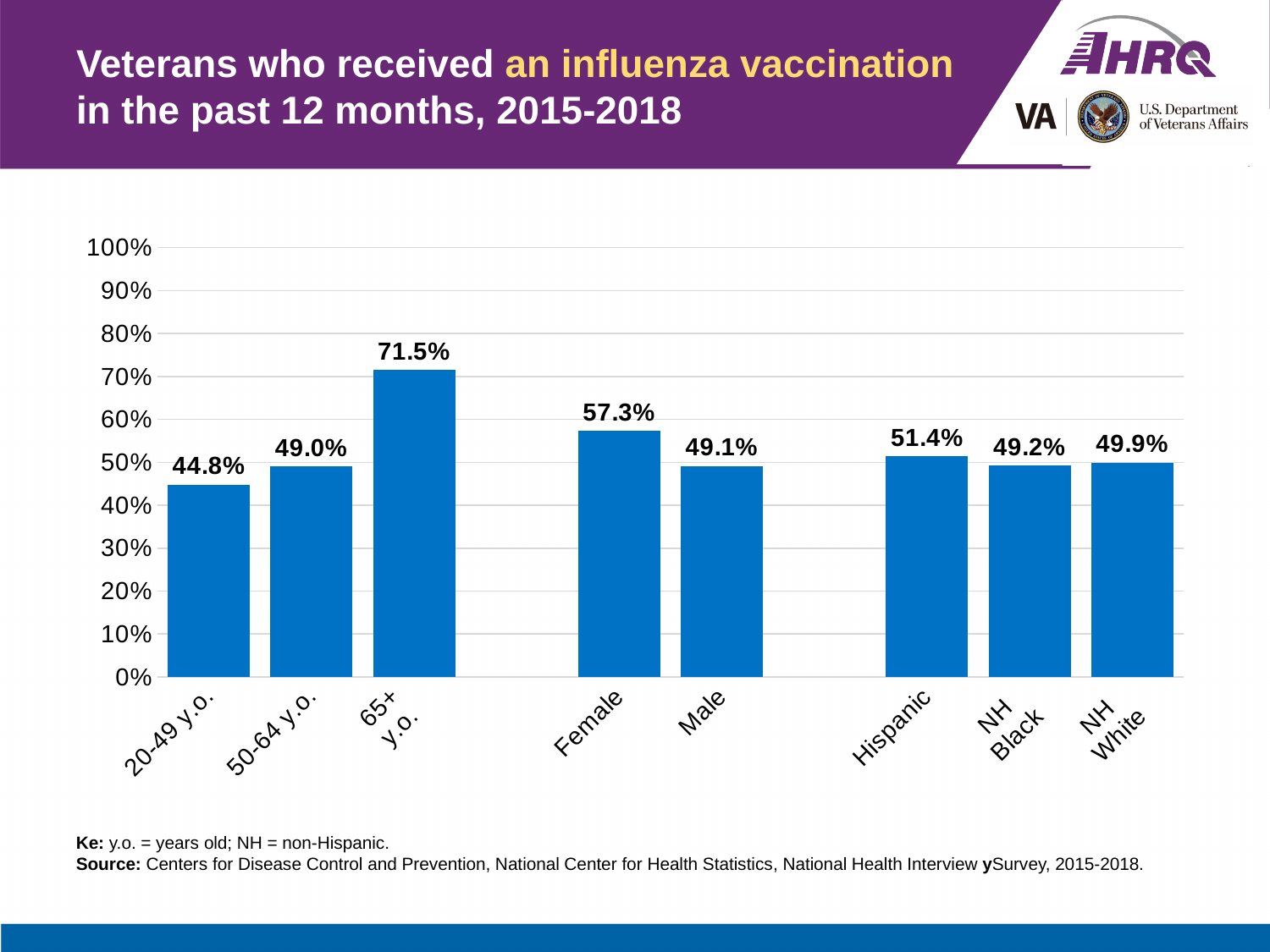
Which is larger, the value for Hispanic veterans or the value for NH Black veterans? Hispanic What is the value shown for Hispanic veterans? 51.4% What percentage of veterans aged 65+ y.o. received an influenza vaccination in the past 12 months? 71.5% What is the difference between the vaccination rates for 65+ y.o. and 20-49 y.o. veterans? 26.7 percentage points Is the value for 20-49 y.o. veterans greater or less than 50%? less Which category has the lowest influenza vaccination rate? 20-49 y.o. What is the value shown for Female veterans? 57.3% What kind of chart is shown on the slide? Bar chart Do the values rise or fall across the three age groups from 20-49 y.o. to 65+ y.o.? Rise What is the difference between the vaccination rates for Female and Male veterans? 8.2 percentage points How many categories are shown on the x axis? 8 Which category has the highest influenza vaccination rate? 65+ y.o.